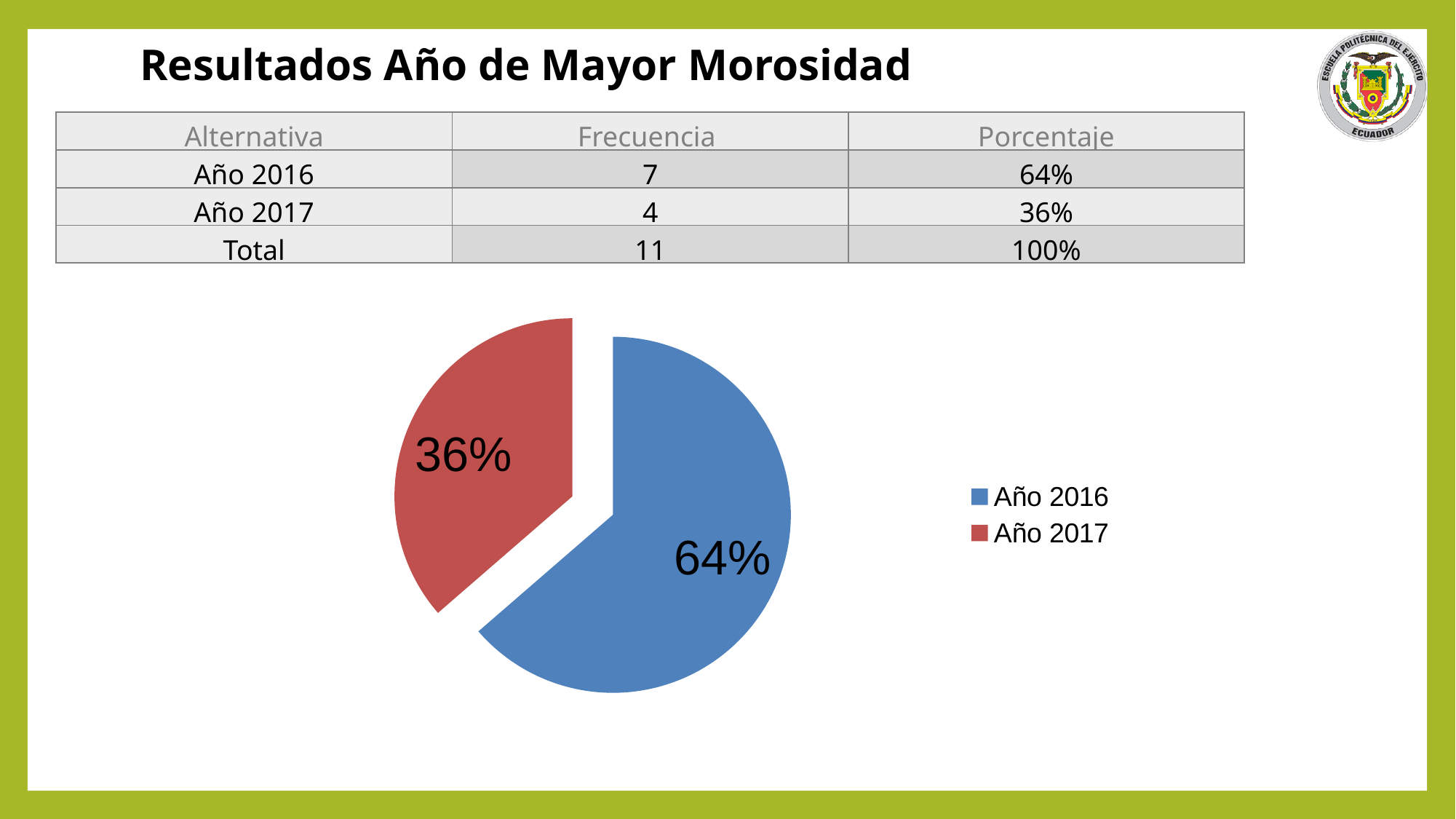
What colour is the Año 2016 slice in the pie chart? Blue What is the difference in percentage points between the Año 2016 and Año 2017 slices? 28 What colour is the Año 2017 slice in the pie chart? Red How many entries does the legend list? 2 Is the share for Año 2017 greater or less than 50%? less What percentage does the pie chart show for Año 2017? 36% What type of chart is shown on the slide? Pie chart What percentage does the pie chart show for Año 2016? 64% Which category has the largest slice in the pie chart? Año 2016 How many slices does the pie chart have? 2 Which category has the smallest slice in the pie chart? Año 2017 Which slice is larger, Año 2016 or Año 2017? Año 2016